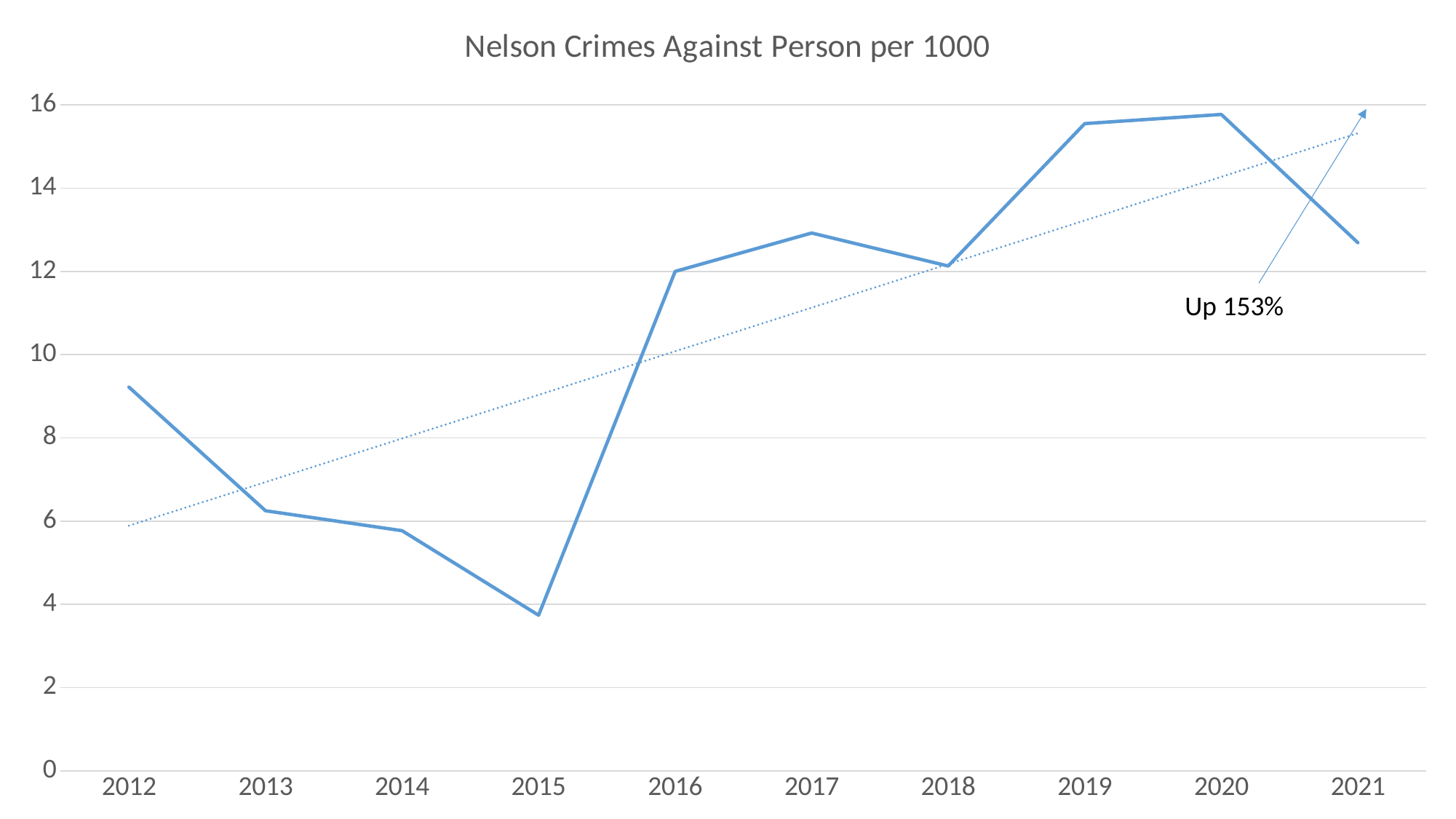
Which year has the lowest value? 2015 Is the value for 2019 greater or less than 14? greater Is the value for 2013 greater or less than 8? less What type of chart is shown on the slide? Line chart Is the value for 2015 greater or less than 4? less How many years are plotted along the x axis? 10 Which is larger, the value for 2019 or the value for 2021? 2019 Which is larger, the value for 2012 or the value for 2013? 2012 What is the title of the chart? Nelson Crimes Against Person per 1000 What percentage change does the annotation on the chart state? Up 153%